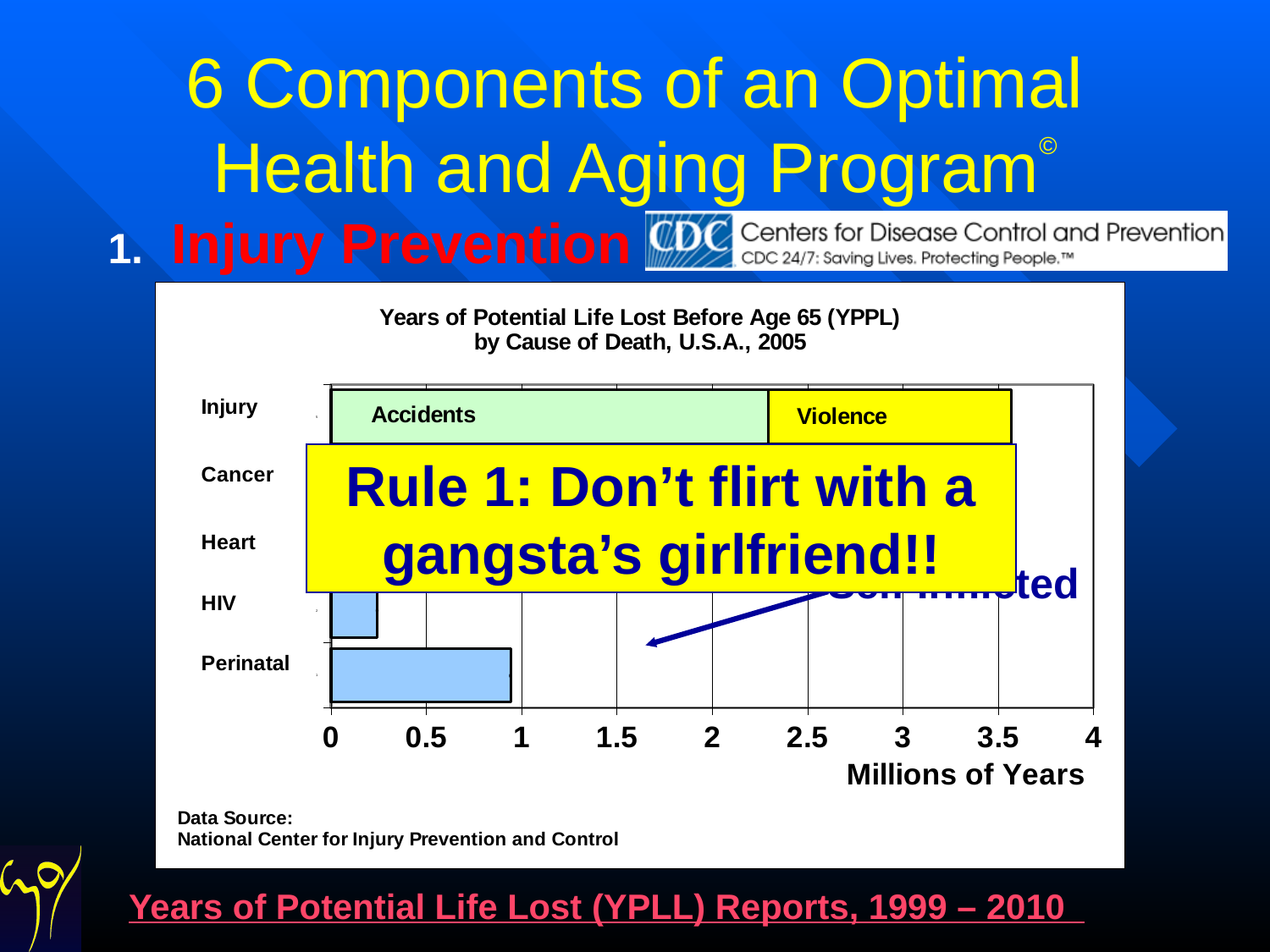
Is the value for Perinatal greater or less than 0.5 million years? greater Which is larger, the value for Perinatal or the value for HIV? Perinatal What are the two segments that make up the Injury bar? Accidents and Violence What is the title of the chart? Years of Potential Life Lost Before Age 65 (YPPL) by Cause of Death, U.S.A., 2005 What is the label of the horizontal axis? Millions of Years Which cause of death has the highest years of potential life lost on the chart? Injury How many causes of death are listed on the chart's vertical axis? 5 Is the value for Injury greater or less than 3 million years? greater What kind of chart is shown on the slide? bar chart Is the value for HIV greater or less than 0.5 million years? less